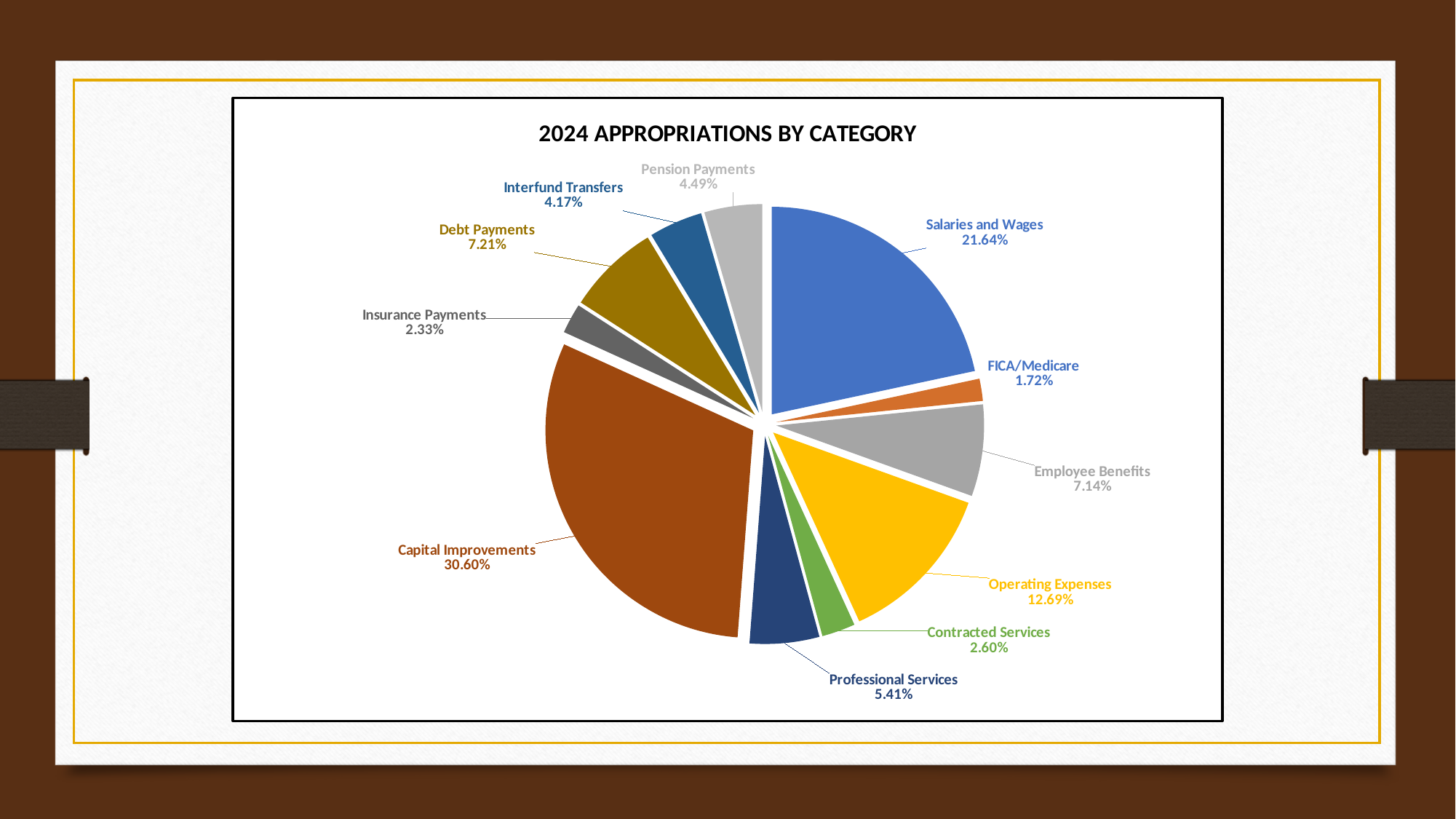
What is the difference in percentage points between Capital Improvements and Salaries and Wages? 8.96% What percentage is shown for Salaries and Wages? 21.64% What percentage is shown for Operating Expenses? 12.69% Which is larger, Professional Services or Contracted Services? Professional Services Which category has the smallest share of the pie? FICA/Medicare What share of 2024 appropriations is Capital Improvements? 30.60% What percentage is shown for Pension Payments? 4.49% What type of chart is shown on the slide? pie chart What is the title of the chart? 2024 APPROPRIATIONS BY CATEGORY Which category has the largest share of the pie? Capital Improvements What is the difference in percentage points between Operating Expenses and Employee Benefits? 5.55% How many categories are shown in the pie chart? 11